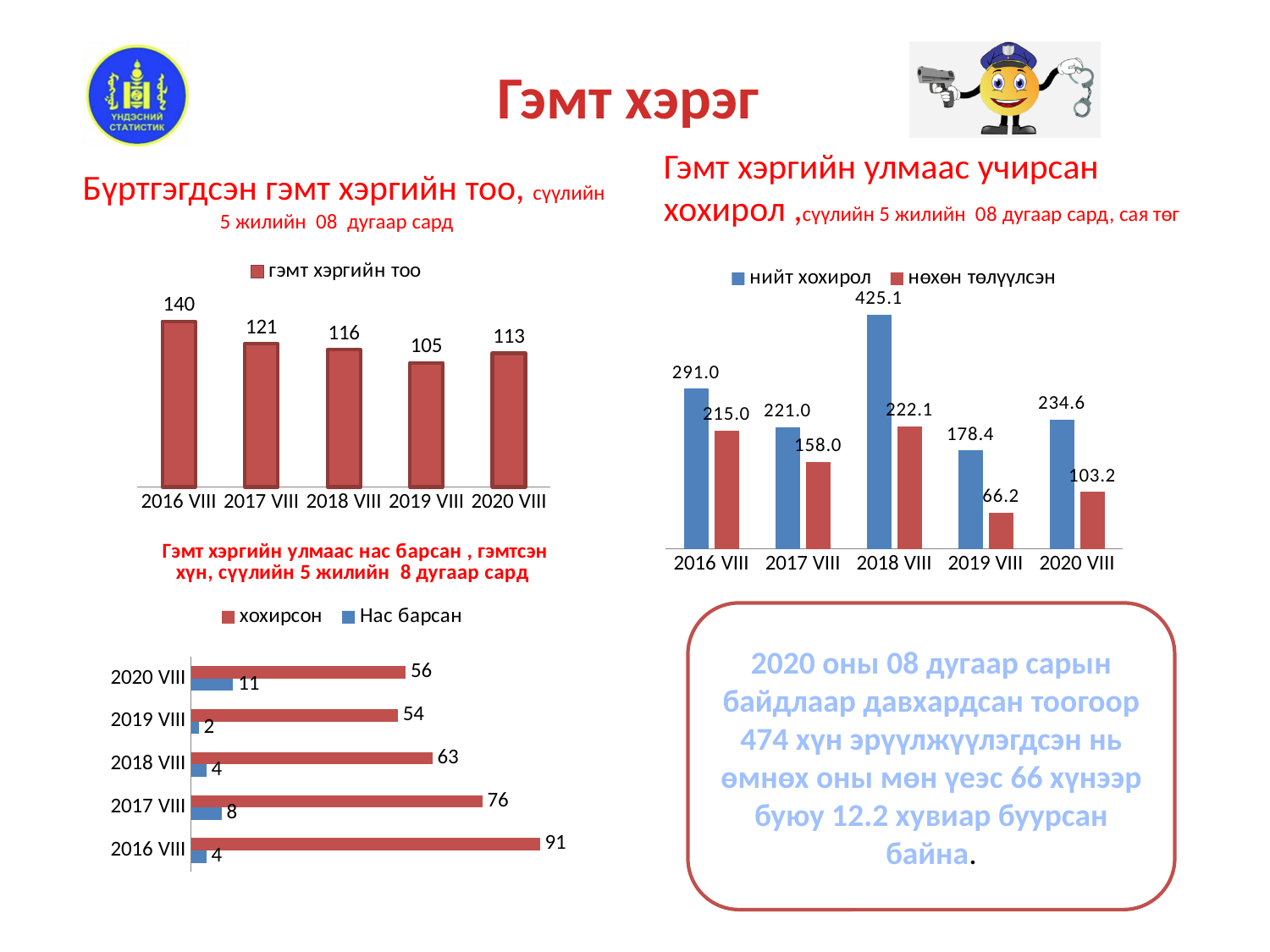
In the bottom-left chart 'Гэмт хэргийн улмаас нас барсан, гэмтсэн хүн', what is the 'хохирсон' value for 2016 VIII? 91 In the top-right chart 'Гэмт хэргийн улмаас учирсан хохирол', what is the difference between 'нийт хохирол' and 'нөхөн төлүүлсэн' for 2020 VIII? 131.4 In the top-left chart 'Бүртгэгдсэн гэмт хэргийн тоо', which period has the lowest value? 2019 VIII In the top-left chart 'Бүртгэгдсэн гэмт хэргийн тоо', what is the difference between the values for 2016 VIII and 2020 VIII? 27 In the top-left chart 'Бүртгэгдсэн гэмт хэргийн тоо', how many periods are shown on the x axis? 5 What kind of chart is the bottom-left chart 'Гэмт хэргийн улмаас нас барсан, гэмтсэн хүн'? Bar chart In the top-right chart 'Гэмт хэргийн улмаас учирсан хохирол', what is the value of 'нийт хохирол' for 2018 VIII? 425.1 In the top-right chart 'Гэмт хэргийн улмаас учирсан хохирол', how many series does the legend list? 2 In the top-right chart 'Гэмт хэргийн улмаас учирсан хохирол', what is the value of 'нөхөн төлүүлсэн' for 2019 VIII? 66.2 In the top-right chart 'Гэмт хэргийн улмаас учирсан хохирол', which period has the highest 'нийт хохирол' value? 2018 VIII In the top-left chart 'Бүртгэгдсэн гэмт хэргийн тоо', what is the value for 2016 VIII? 140 In the bottom-left chart 'Гэмт хэргийн улмаас нас барсан, гэмтсэн хүн', which period has the highest 'Нас барсан' value? 2020 VIII